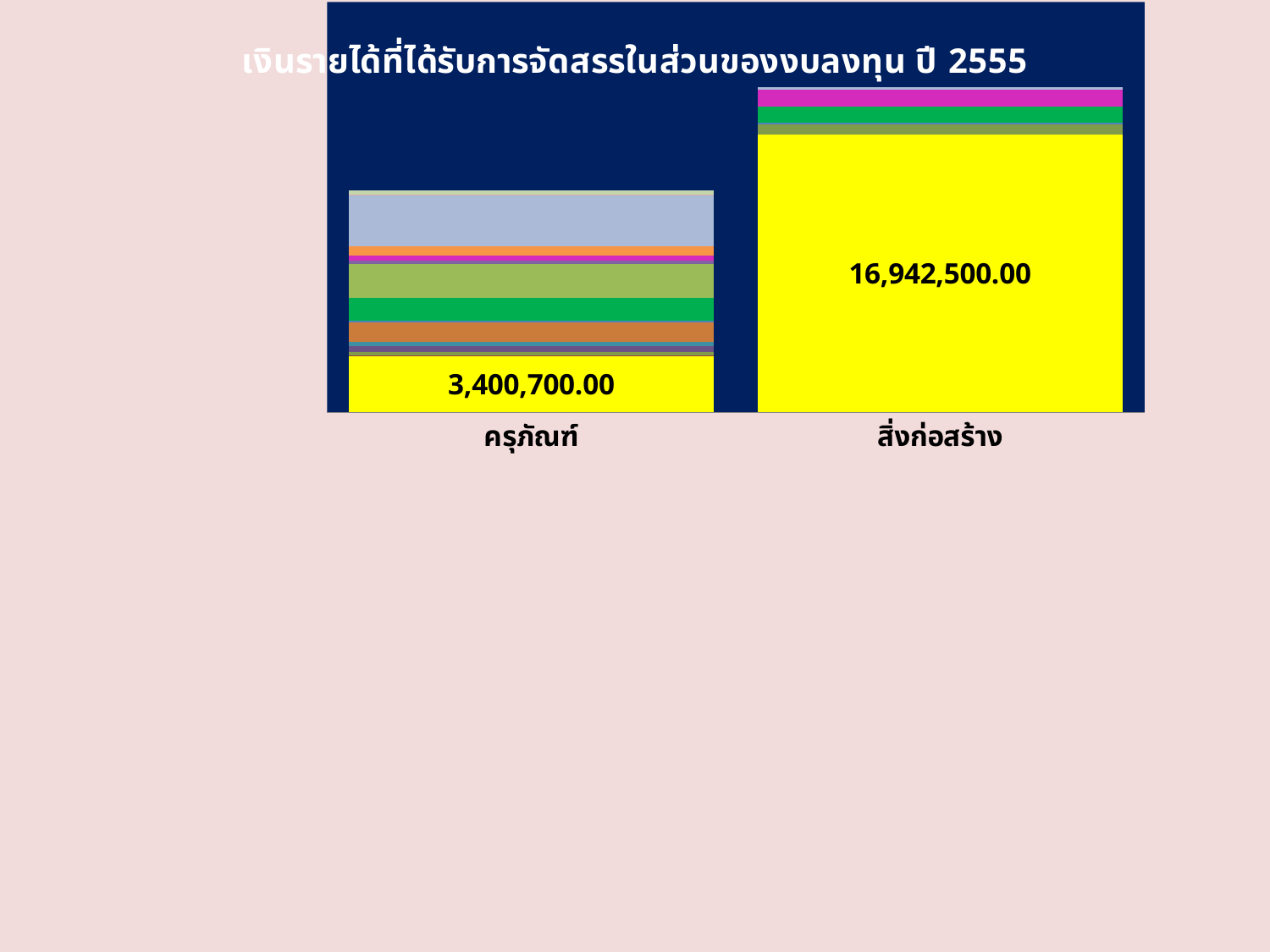
What value is printed on the yellow segment of the ครุภัณฑ์ bar? 3,400,700.00 How many categories are shown on the x axis? 2 What colour is the segment that carries the printed value labels in both bars? Yellow What is the title of the chart? เงินรายได้ที่ได้รับการจัดสรรในส่วนของงบลงทุน ปี 2555 Which category has the taller bar, ครุภัณฑ์ or สิ่งก่อสร้าง? สิ่งก่อสร้าง What kind of chart is shown on the slide? Stacked bar chart What value is printed on the yellow segment of the สิ่งก่อสร้าง bar? 16,942,500.00 Which category has the shorter bar? ครุภัณฑ์ What is the difference between the printed values 16,942,500.00 (สิ่งก่อสร้าง) and 3,400,700.00 (ครุภัณฑ์)? 13,541,800.00 Which printed value is larger: 3,400,700.00 for ครุภัณฑ์ or 16,942,500.00 for สิ่งก่อสร้าง? 16,942,500.00 for สิ่งก่อสร้าง